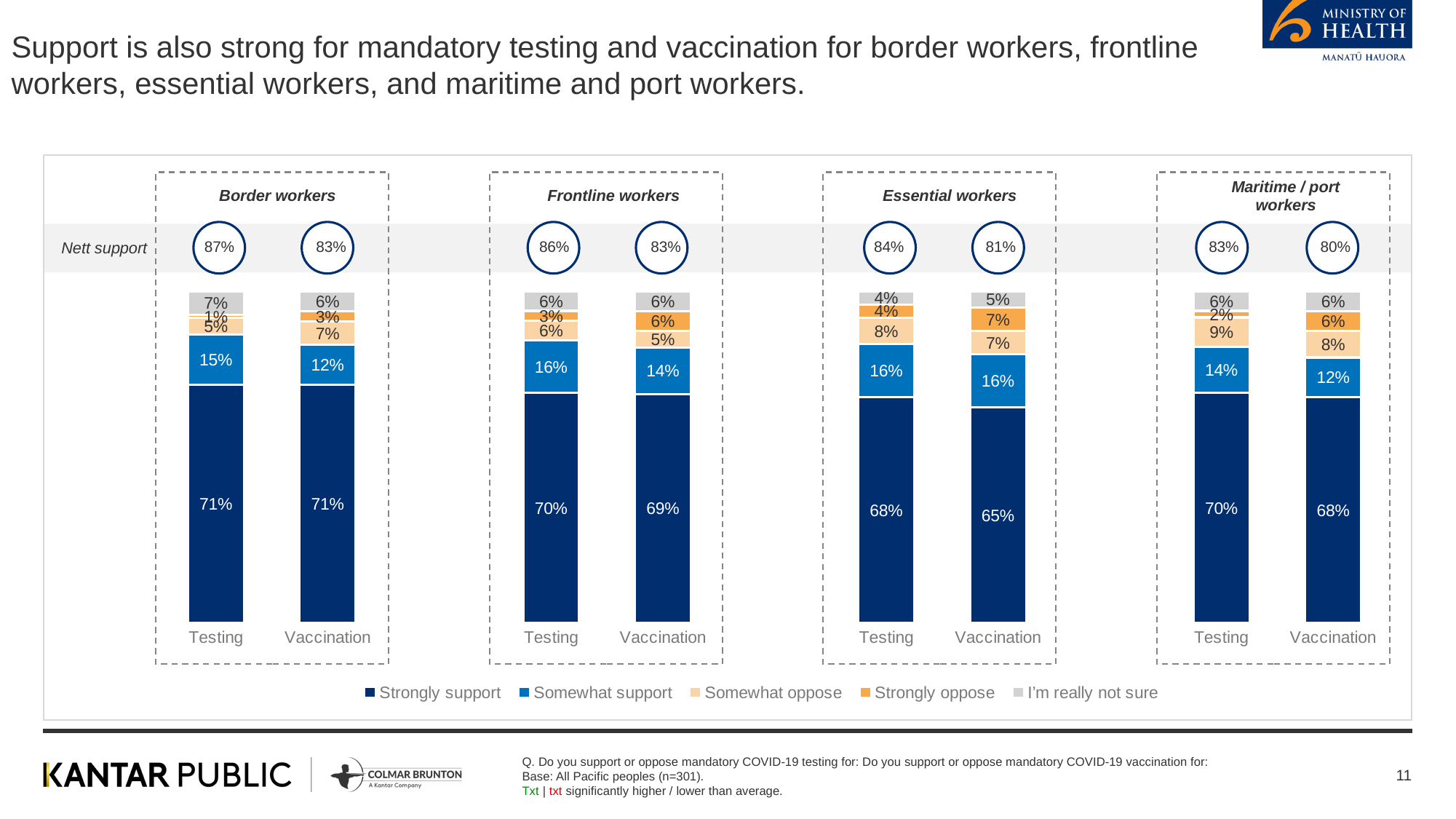
What percentage somewhat support mandatory vaccination for essential workers? 16% What kind of chart is shown on the slide? Stacked bar chart Which bar has the lowest 'Strongly support' percentage? Essential workers – Vaccination (65%) What percentage strongly oppose mandatory testing for border workers? 1% How many series does the legend list? 5 How many bars are plotted in the chart? 8 Which worker group and measure has the highest nett support? Border workers – Testing (87%) What is the difference between nett support for testing and vaccination for essential workers? 3 percentage points Which is larger: the 'Strongly oppose' share for frontline workers vaccination or for frontline workers testing? Frontline workers vaccination (6%) What percentage of respondents strongly support mandatory testing for border workers? 71% Which legend entry is shown in dark blue? Strongly support What is the nett support for mandatory vaccination for maritime / port workers? 80%